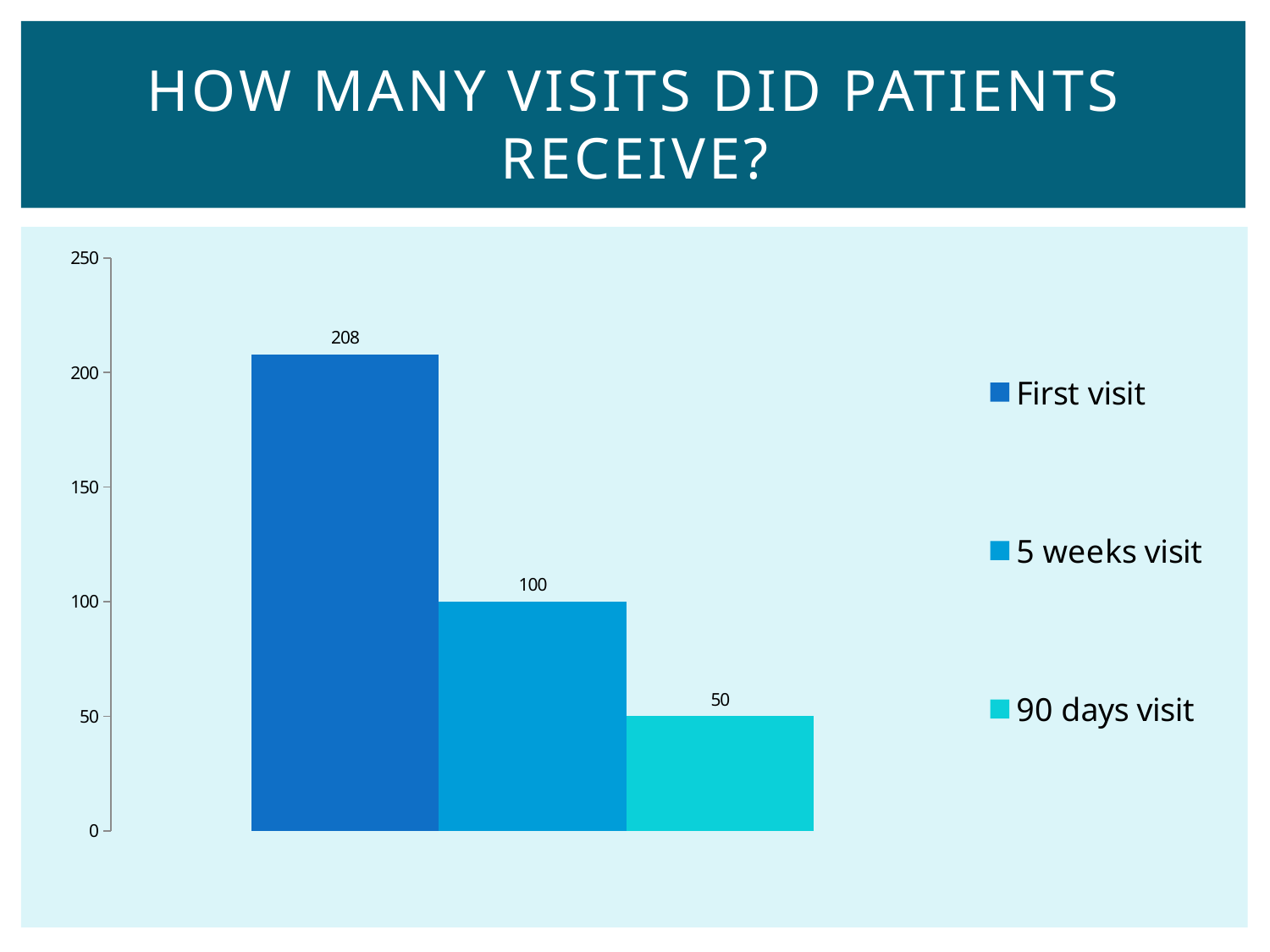
What is the value for First visit? 208 How many series does the legend list? 3 Which series has the highest value? First visit What is the difference between the 5 weeks visit and 90 days visit values? 50 What is the title of the slide? HOW MANY VISITS DID PATIENTS RECEIVE? What is the value for 90 days visit? 50 What kind of chart is shown on the slide? bar chart Which is larger, the value for 5 weeks visit or the value for 90 days visit? 5 weeks visit What is the difference between the First visit and 5 weeks visit values? 108 Is the value for First visit greater or less than 200? greater Which series has the lowest value? 90 days visit What is the value for 5 weeks visit? 100